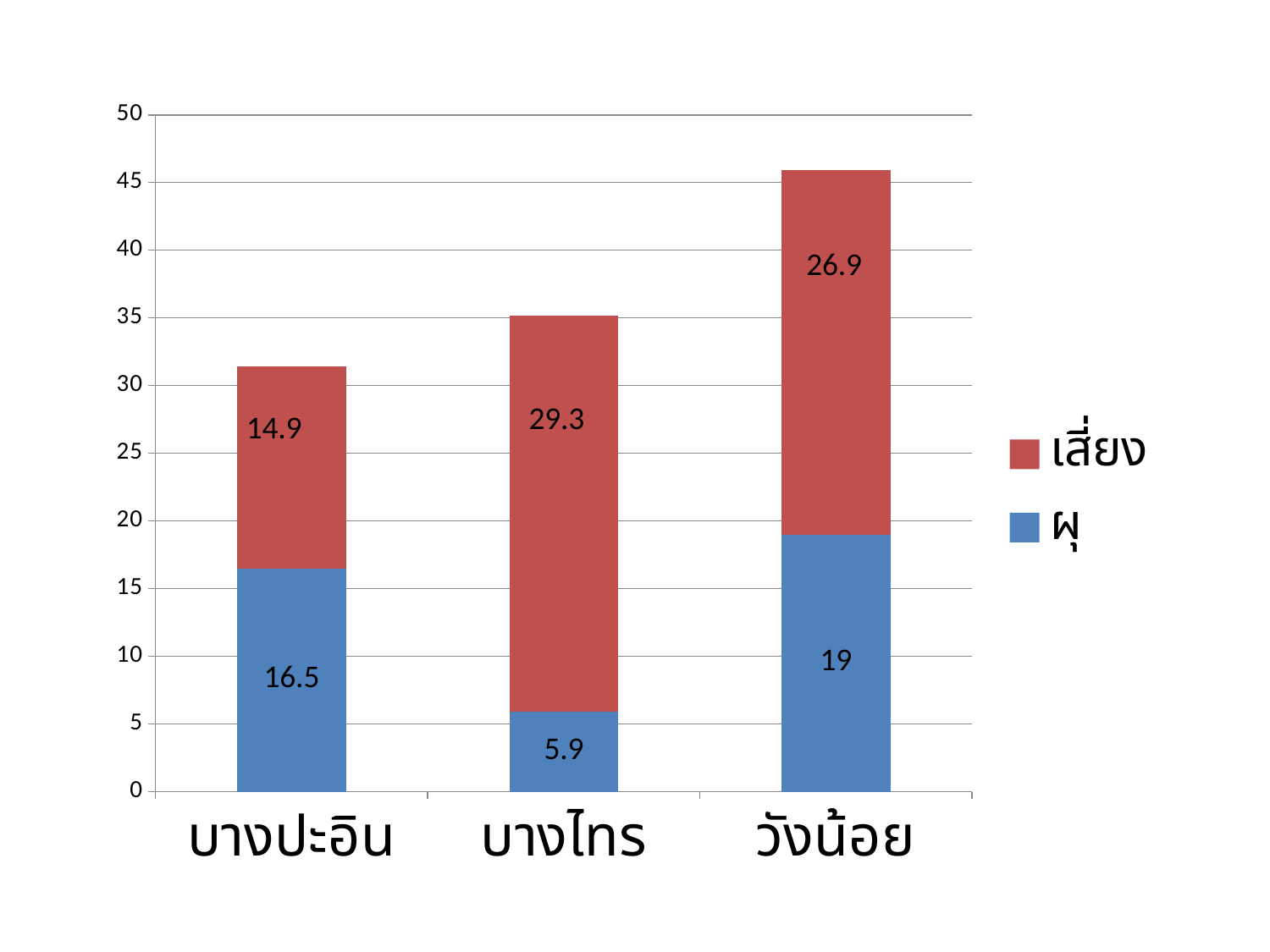
Which is larger for บางปะอิน, the ผุ value or the เสี่ยง value? ผุ What is the value of ผุ for วังน้อย? 19 Which category has the lowest value for ผุ? บางไทร How many categories are shown on the x axis? 3 What kind of chart is shown on the slide? Stacked bar chart How many series does the legend list? 2 What is the difference between the เสี่ยง value and the ผุ value for บางไทร? 23.4 What is the total of the stacked bar for วังน้อย? 45.9 Which category has the highest value for เสี่ยง? บางไทร What is the value of เสี่ยง for วังน้อย? 26.9 What is the value of เสี่ยง for บางไทร? 29.3 What is the value of ผุ for บางปะอิน? 16.5